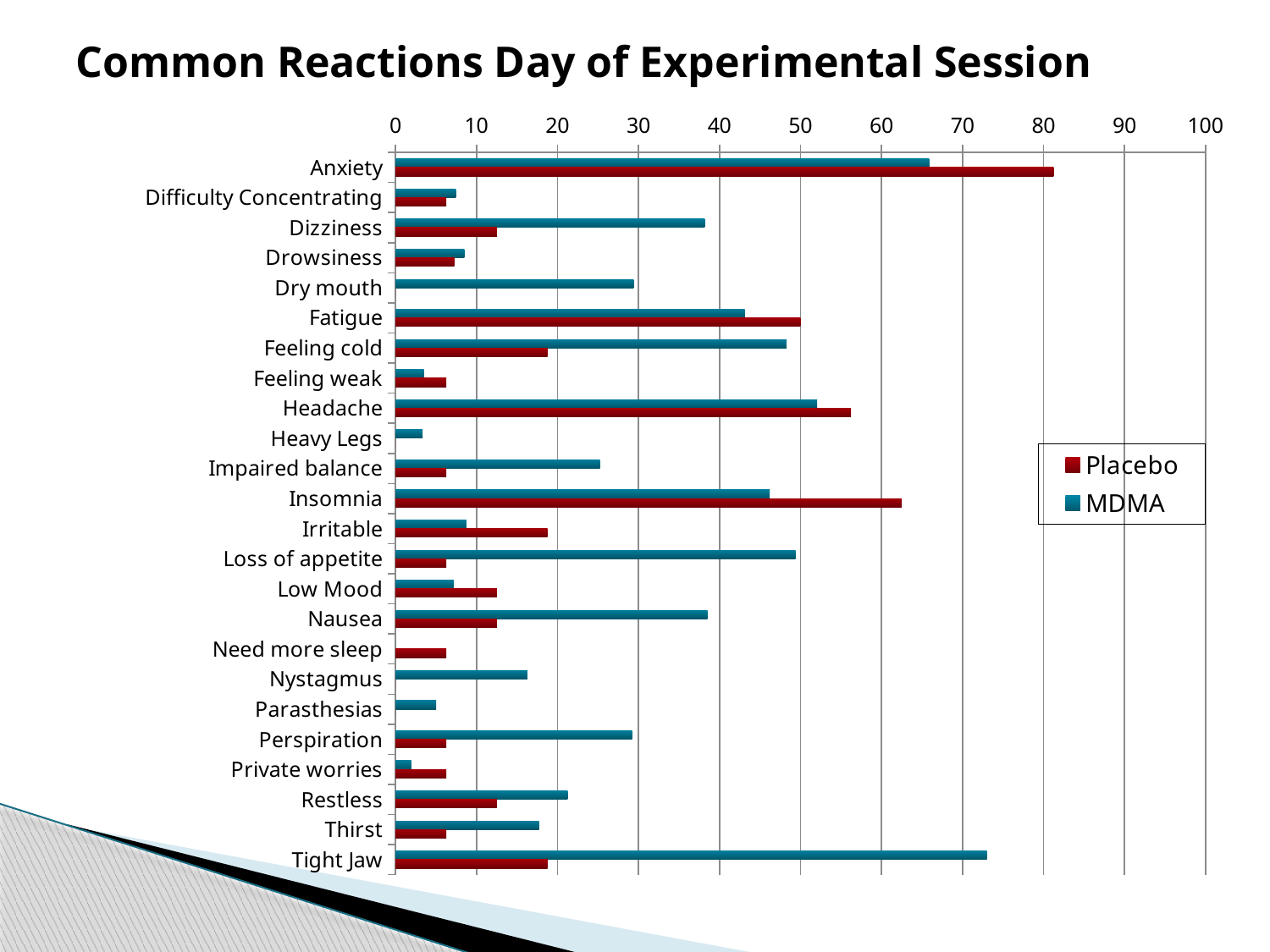
Is the MDMA value for Dizziness greater or less than 30? greater How many reaction categories are plotted on the chart? 24 For Insomnia, which series has the larger value, Placebo or MDMA? Placebo Is the Placebo value for Anxiety greater or less than 70? greater For Nausea, which series has the larger value, Placebo or MDMA? MDMA Which reaction has the highest Placebo value? Anxiety What kind of chart is shown on the slide? Bar chart What are the two series named in the legend? Placebo and MDMA Which reaction has the highest MDMA value? Tight Jaw How many series does the legend list? 2 Is the MDMA value for Dry mouth greater or less than 40? less